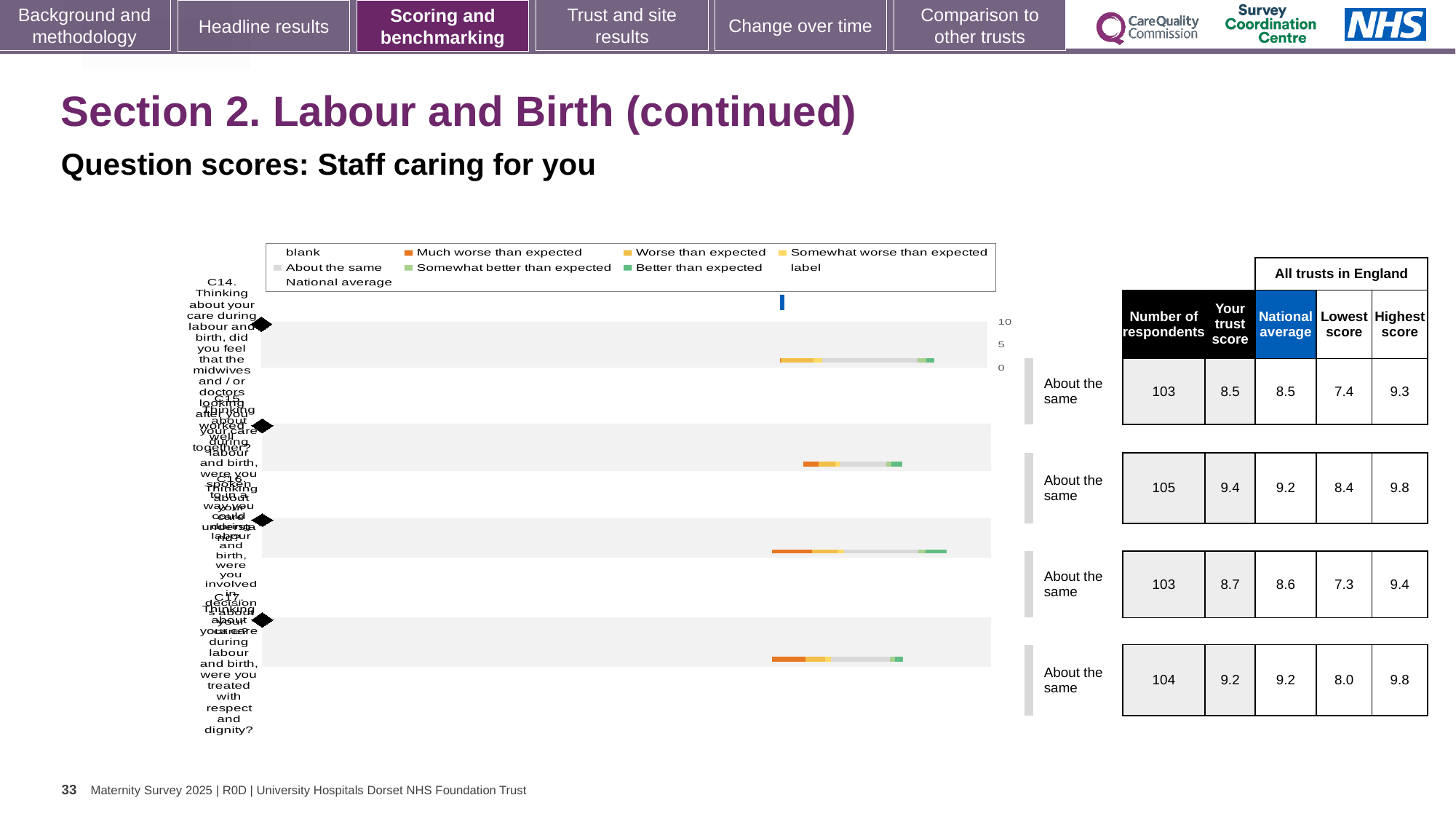
Which is larger: the highest score for C14 or the highest score for C16? C16 Which question has the highest trust score? C15 What is the benchmark category shown for question C17? About the same What is the difference between the trust score and the national average for question C15? 0.2 What is the national average for question C16? 8.6 What kind of chart is shown on the slide? bar chart How many questions (C14 to C17) are plotted in the chart? 4 In the chart legend, which colour represents 'Much worse than expected'? orange What is the trust score for question C15? 9.4 In the chart legend, which category is shown in dark green? Better than expected What is the number of respondents for question C14? 103 Which question has the lowest 'Lowest score' across all trusts in England? C16